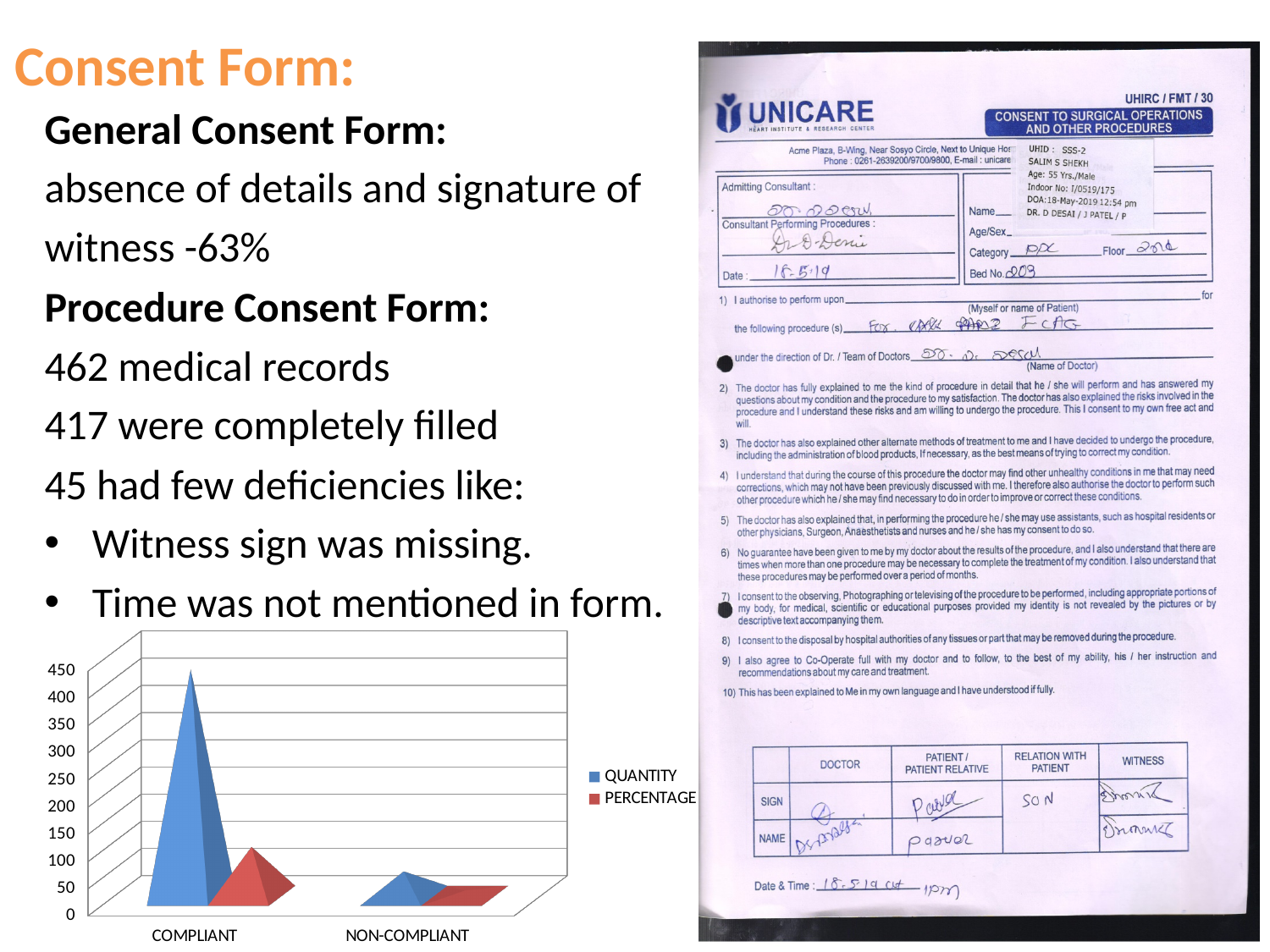
For the COMPLIANT category, which is larger: the QUANTITY value or the PERCENTAGE value? QUANTITY Is the PERCENTAGE value for NON-COMPLIANT greater or less than 50? less Is the PERCENTAGE value for COMPLIANT greater or less than 150? less How many series does the chart legend list? 2 Is the QUANTITY value for COMPLIANT greater or less than 350? greater Which category has the highest QUANTITY value in the chart? COMPLIANT What are the two series named in the chart legend? QUANTITY and PERCENTAGE How many categories are shown on the x axis of the chart? 2 Which category has the lowest QUANTITY value in the chart? NON-COMPLIANT What is the highest value labelled on the chart's vertical axis? 450 Which series is shown in red in the chart? PERCENTAGE